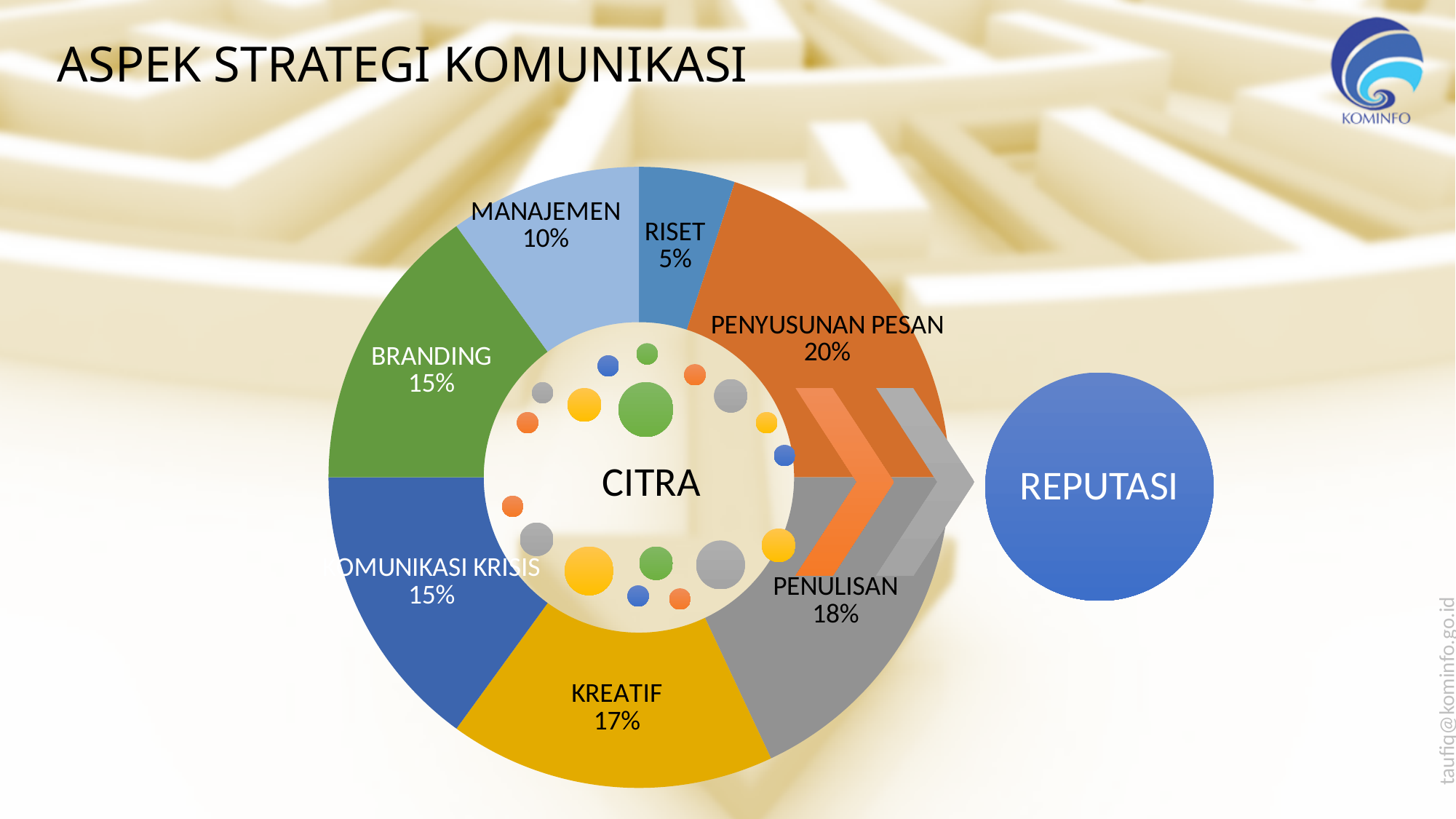
What is the difference between the shares of PENYUSUNAN PESAN and MANAJEMEN? 10% What percentage is shown for KREATIF? 17% What word is written in the centre of the chart? CITRA Which two segments both have a share of 15%? BRANDING and KOMUNIKASI KRISIS What percentage is shown for PENULISAN? 18% Which is larger, the share for PENULISAN or the share for KREATIF? PENULISAN How many segments does the chart have? 7 What percentage is shown for PENYUSUNAN PESAN? 20% What kind of chart is shown on the slide? pie chart (doughnut) Which segment has the smallest share? RISET Which segment has the largest share? PENYUSUNAN PESAN What percentage is shown for RISET? 5%